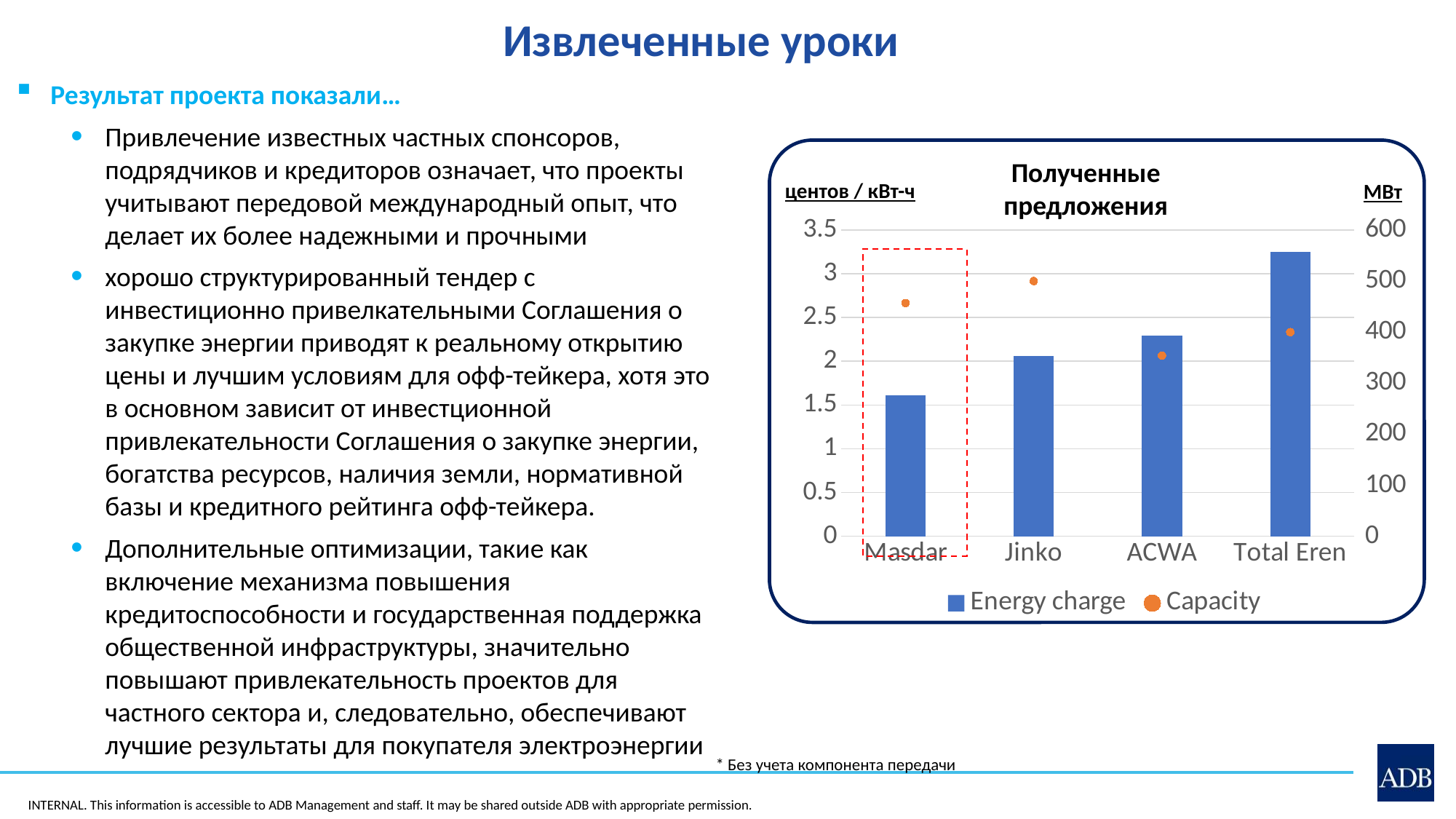
What kind of chart is shown on the slide? Bar chart with a line/marker series (combo chart) What is the title of the chart? Полученные предложения Which bidder has the lowest Energy charge bar? Masdar How many bidders (categories) are shown on the x axis of the chart? 4 Which bidder has a higher Capacity, Jinko or ACWA? Jinko Which bidder has the highest Energy charge bar? Total Eren Is the Energy charge value for Masdar greater or less than 2? less Is the Energy charge value for Total Eren greater or less than 3? greater How many series does the chart legend list? 2 Do the Energy charge bars rise or fall from Masdar to Total Eren? rise Which bidder has a larger Energy charge, Jinko or ACWA? ACWA Is the Capacity value for Jinko greater or less than 400? greater